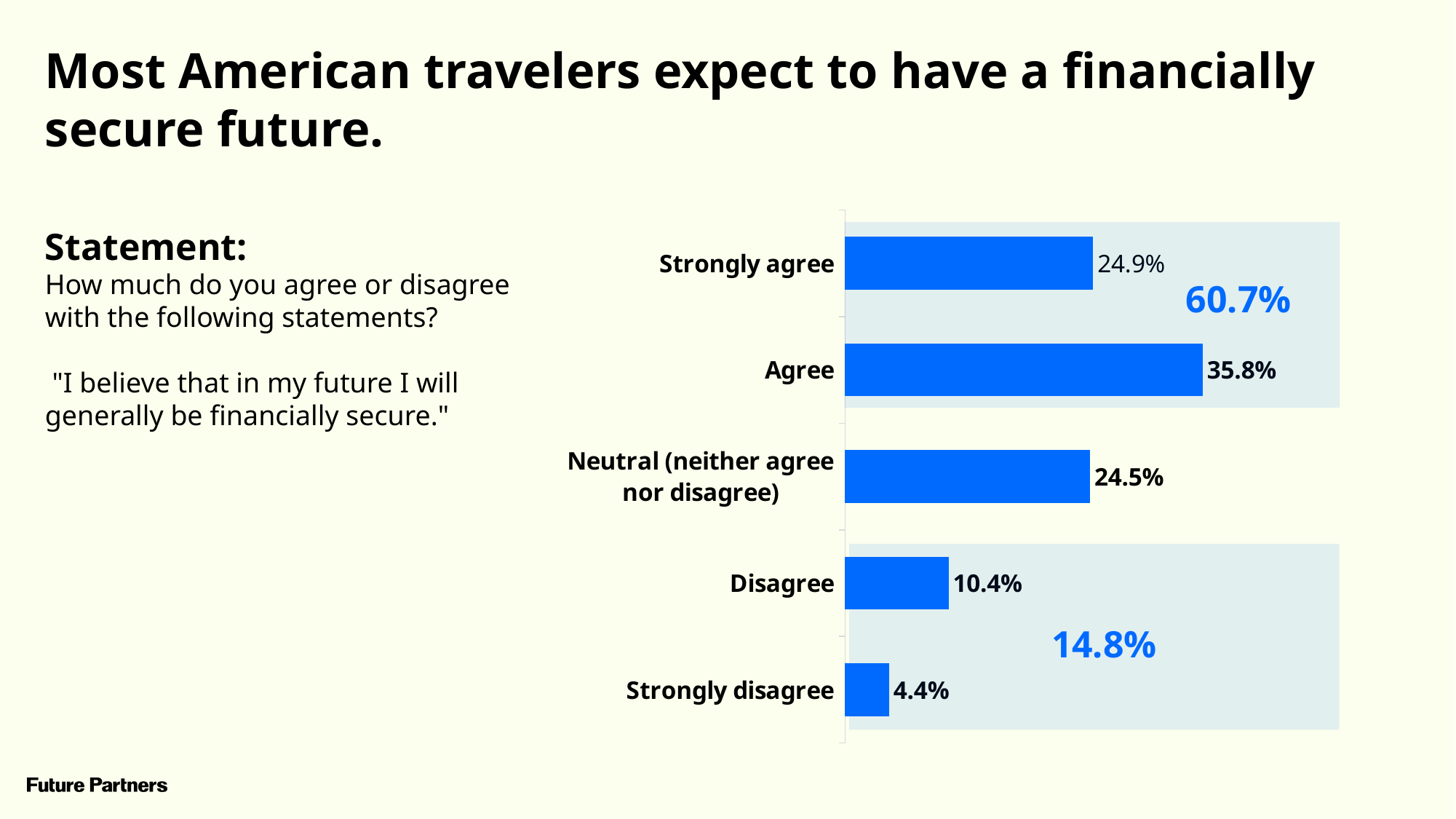
What combined percentage is shown for Disagree and Strongly disagree together? 14.8% How many response categories are shown in the chart? 5 Which response category has the highest value? Agree Which response category has the lowest value? Strongly disagree What is the difference between the Agree and Disagree values? 25.4% Which is larger, the value for Disagree or the value for Strongly disagree? Disagree What combined percentage is shown for Strongly agree and Agree together? 60.7% What percentage of respondents chose Agree? 35.8% What kind of chart is shown on the slide? Bar chart What percentage of respondents strongly disagree? 4.4% What percentage of respondents strongly agree with the statement? 24.9% What is the value for Neutral (neither agree nor disagree)? 24.5%